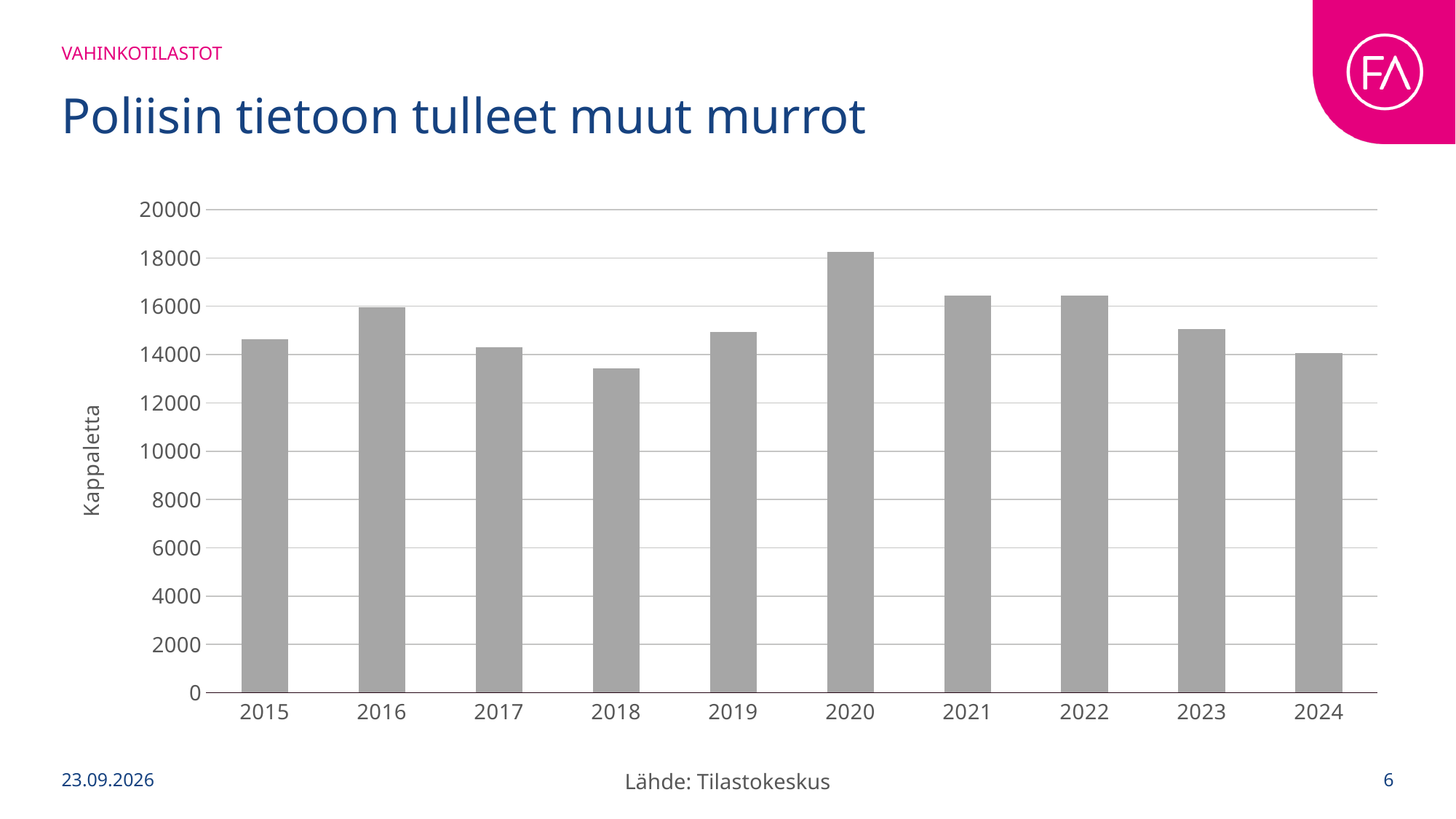
Which year has the lowest bar in the chart? 2018 Which is larger, the value for 2016 or the value for 2020? 2020 Do the values rise or fall from 2022 to 2024? fall Which year has the highest number of reported break-ins in the chart? 2020 Is the value for 2024 greater or less than 12000? greater How many years are shown on the x axis of the chart? 10 Is the value for 2018 greater or less than 14000? less Is the value for 2021 greater or less than 16000? greater What kind of chart is shown on the slide? bar chart What is the label on the y axis of the chart? Kappaletta Which is larger, the value for 2018 or the value for 2019? 2019